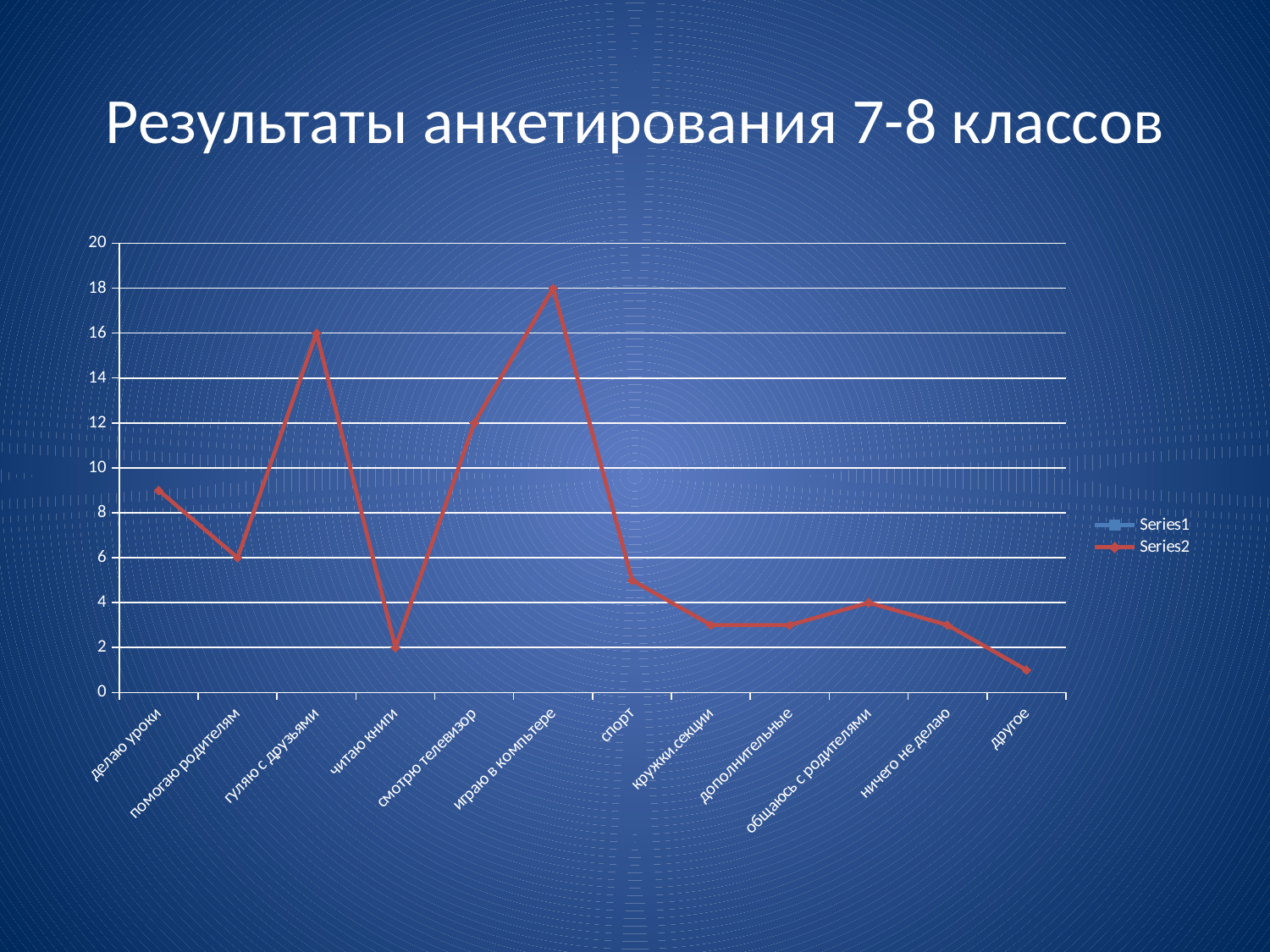
How many categories are shown along the x axis? 12 Which is larger, the value for гуляю с друзьями or the value for смотрю телевизор? гуляю с друзьями Which category has the highest value? играю в компьтере What is the value for читаю книги? 2 Is the value for делаю уроки greater or less than 8? greater What is the title of the chart on the slide? Результаты анкетирования 7-8 классов What is the difference between the values for играю в компьютере and гуляю с друзьями? 2 What is the value for играю в компьютере? 18 How many series does the legend list? 2 Which category has the lowest value? другое What type of chart is shown on the slide? line chart What is the value for гуляю с друзьями? 16